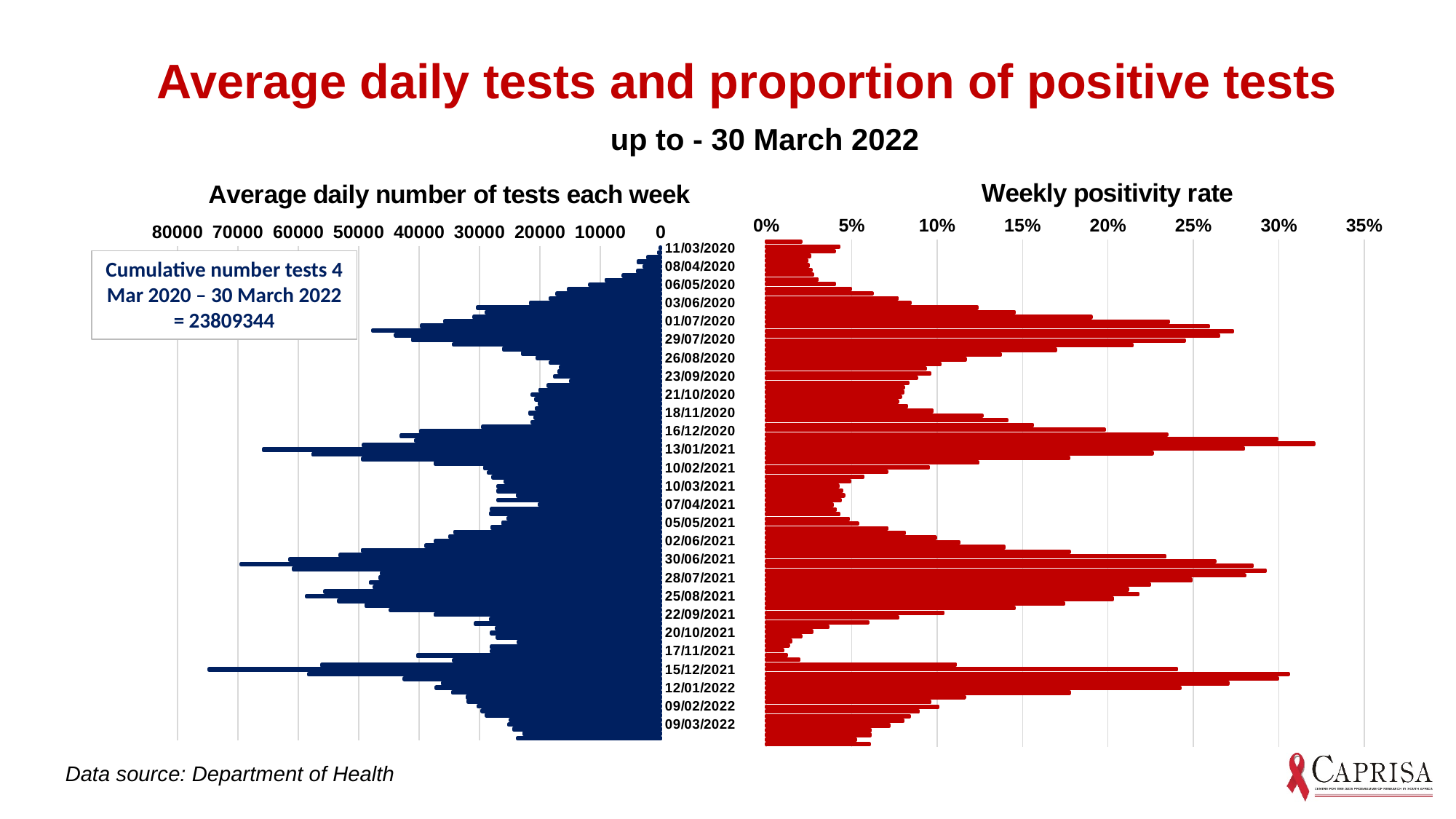
What is the highest value shown on the axis of the 'Weekly positivity rate' chart? 35% In the 'Average daily number of tests each week' chart, is the value for 15/12/2021 greater or less than 70000? greater What type of chart is the 'Average daily number of tests each week' chart? Bar chart In the 'Weekly positivity rate' chart, which is larger, the value for 13/01/2021 or the value for 10/03/2021? 13/01/2021 In the 'Average daily number of tests each week' chart, which is larger, the value for 15/12/2021 or the value for 11/03/2020? 15/12/2021 In the 'Weekly positivity rate' chart, do the values rise or fall from 13/01/2021 to 10/03/2021? fall What type of chart is the 'Weekly positivity rate' chart? Bar chart In the 'Average daily number of tests each week' chart, is the value for 11/03/2020 greater or less than 10000? less In the 'Weekly positivity rate' chart, is the value for 11/03/2020 greater or less than 5%? less